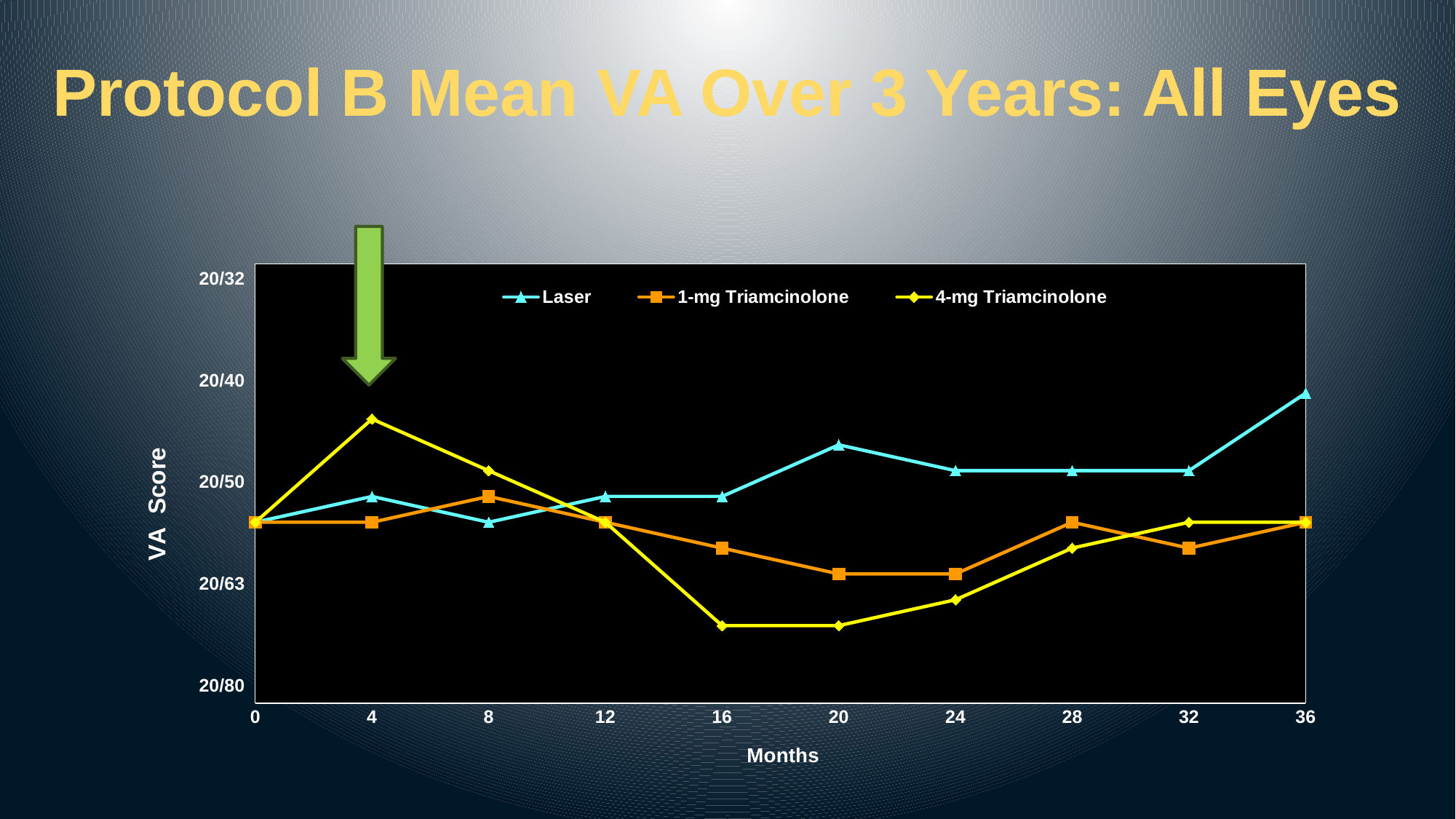
Which series has the lowest VA score at 16 months? 4-mg Triamcinolone Does the Laser line rise or fall between 24 and 36 months? Rise At 20 months, which is higher: Laser or 1-mg Triamcinolone? Laser What kind of chart is shown on the slide? Line chart Which series has the highest VA score at 36 months? Laser At which month does the Laser series reach its highest VA score? 36 What is the label of the x axis? Months Does the 4-mg Triamcinolone line rise or fall between 4 and 16 months? Fall How many time points are plotted along the Months axis? 10 At which month does the 4-mg Triamcinolone series reach its highest VA score? 4 How many series does the legend list? 3